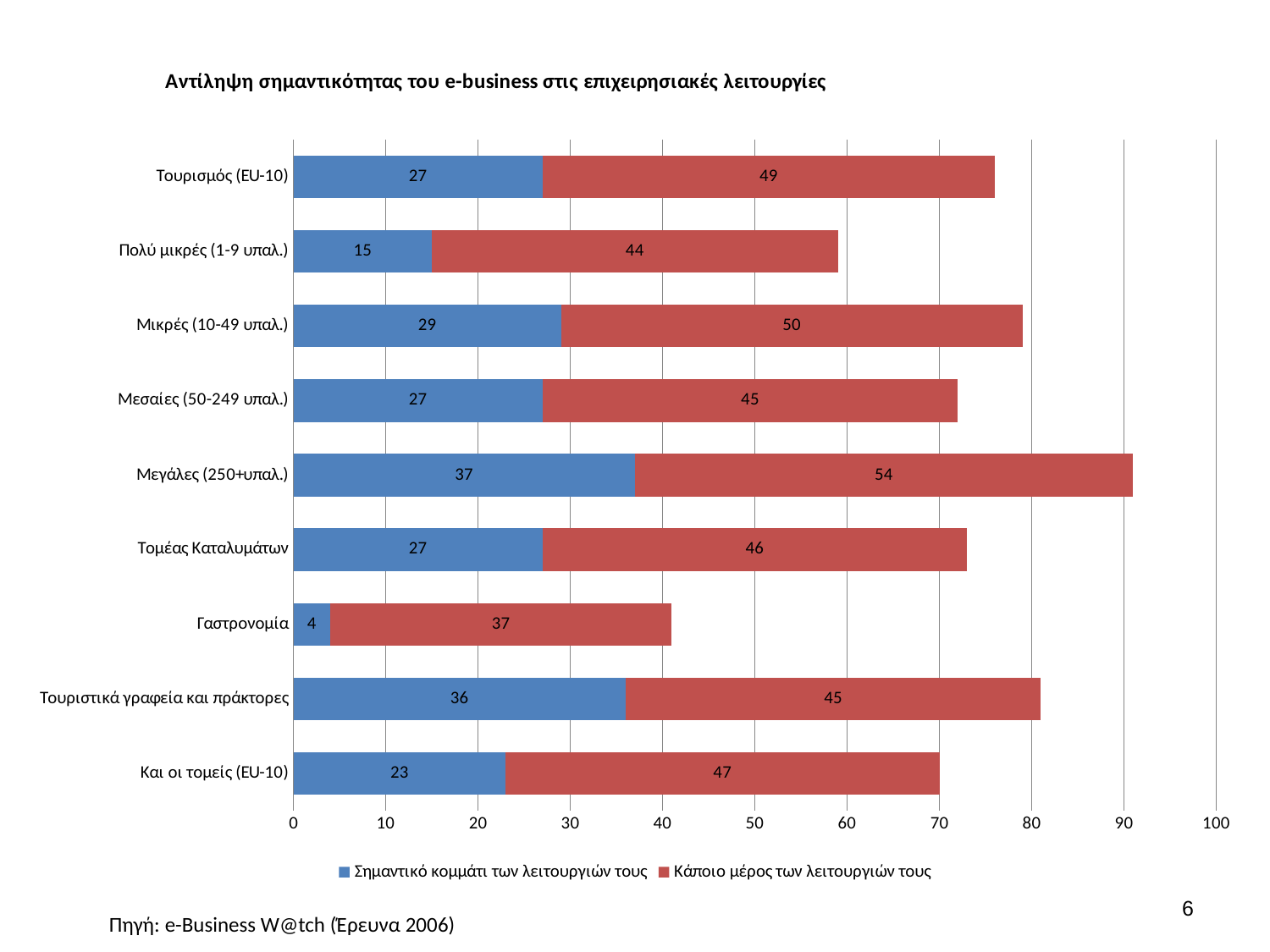
What is the value of 'Κάποιο μέρος των λειτουργιών τους' for Πολύ μικρές (1-9 υπαλ.)? 44 Which is larger: the 'Κάποιο μέρος των λειτουργιών τους' value for Τουρισμός (EU-10) or for Και οι τομείς (EU-10)? Τουρισμός (EU-10) What is the total of the stacked bar for Γαστρονομία? 41 How many categories are shown on the chart? 9 What is the value of 'Σημαντικό κομμάτι των λειτουργιών τους' for Μεγάλες (250+υπαλ.)? 37 What is the difference between the 'Σημαντικό κομμάτι των λειτουργιών τους' values for Μικρές (10-49 υπαλ.) and Πολύ μικρές (1-9 υπαλ.)? 14 How many series does the legend list? 2 Which category has the highest value for 'Κάποιο μέρος των λειτουργιών τους'? Μεγάλες (250+υπαλ.) What type of chart is shown on the slide? Stacked bar chart What is the total of the stacked bar for Μεγάλες (250+υπαλ.)? 91 What is the value of 'Σημαντικό κομμάτι των λειτουργιών τους' for Γαστρονομία? 4 Which category has the lowest value for 'Σημαντικό κομμάτι των λειτουργιών τους'? Γαστρονομία